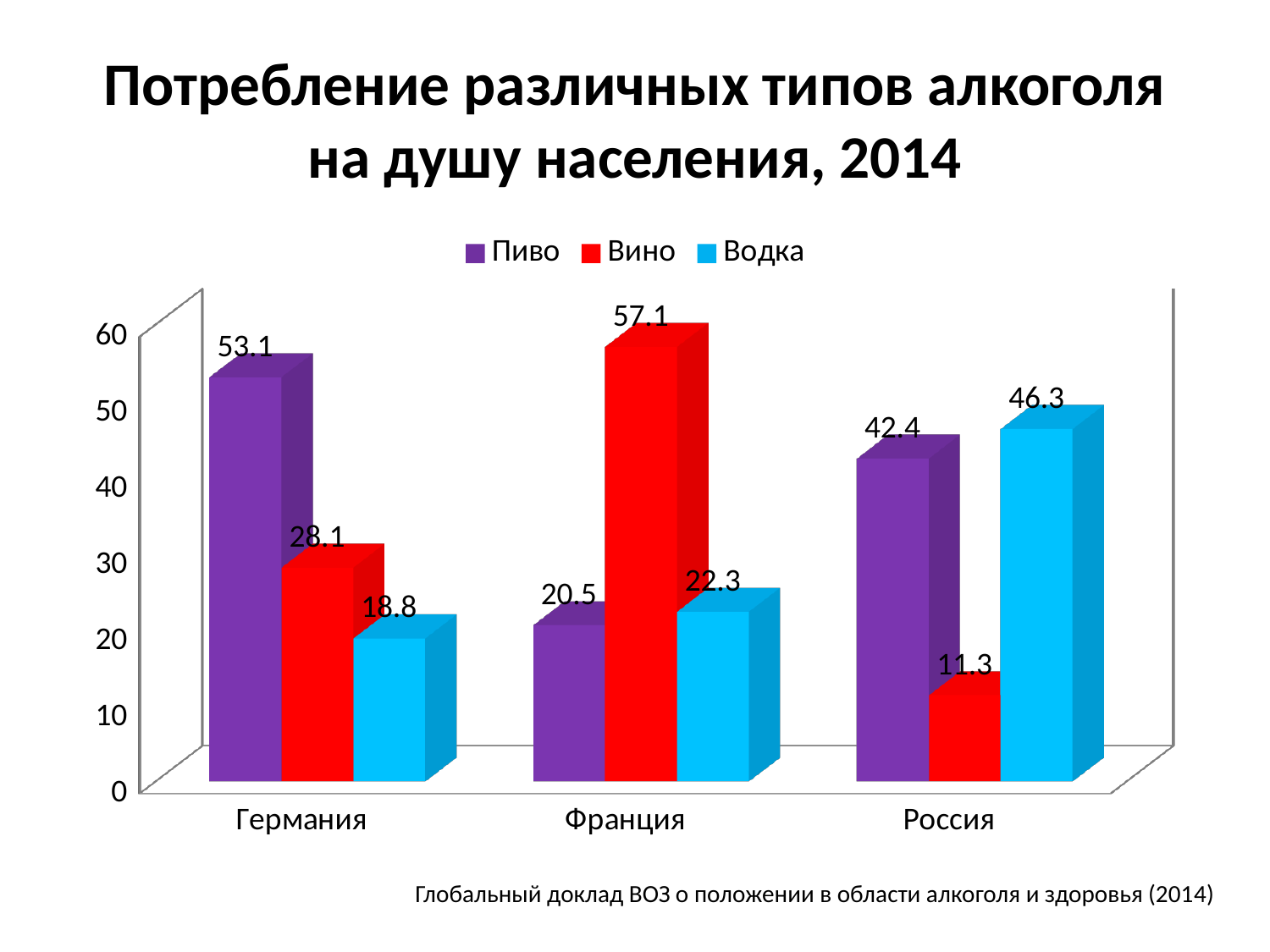
What is the value for Вино in Россия? 11.3 How many countries are shown on the x axis? 3 Which country has the highest value for Пиво? Германия What is the value for Пиво in Германия? 53.1 Which colour represents Водка in the legend? Light blue What is the difference between Пиво and Вино in Германия? 25 How many series does the legend list? 3 What kind of chart is this? Bar chart What is the value for Водка in Россия? 46.3 Which is larger in Россия: Пиво or Водка? Водка What is the value for Вино in Франция? 57.1 Which country has the lowest value for Вино? Россия